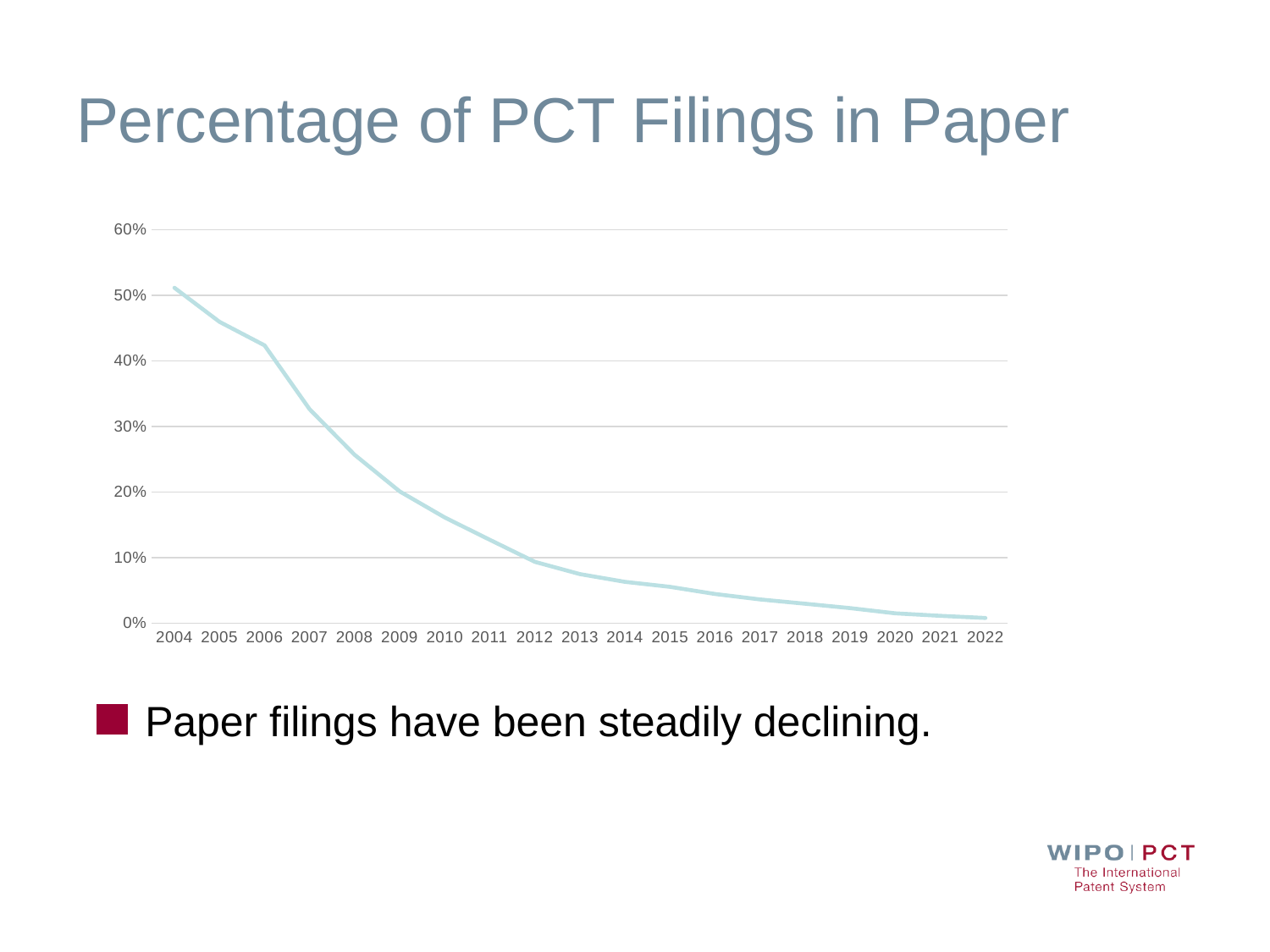
What kind of chart is shown on the slide? line chart Is the value for 2004 greater or less than 40%? greater Is the value for 2008 greater or less than 20%? greater Is the value for 2006 greater or less than 40%? greater Which year has the larger value, 2005 or 2010? 2005 Which year has the lowest percentage of PCT filings in paper? 2022 What is the title of the chart? Percentage of PCT Filings in Paper Which year has the highest percentage of PCT filings in paper? 2004 How many years are plotted along the x axis? 19 Do the values rise or fall from 2004 to 2022? fall